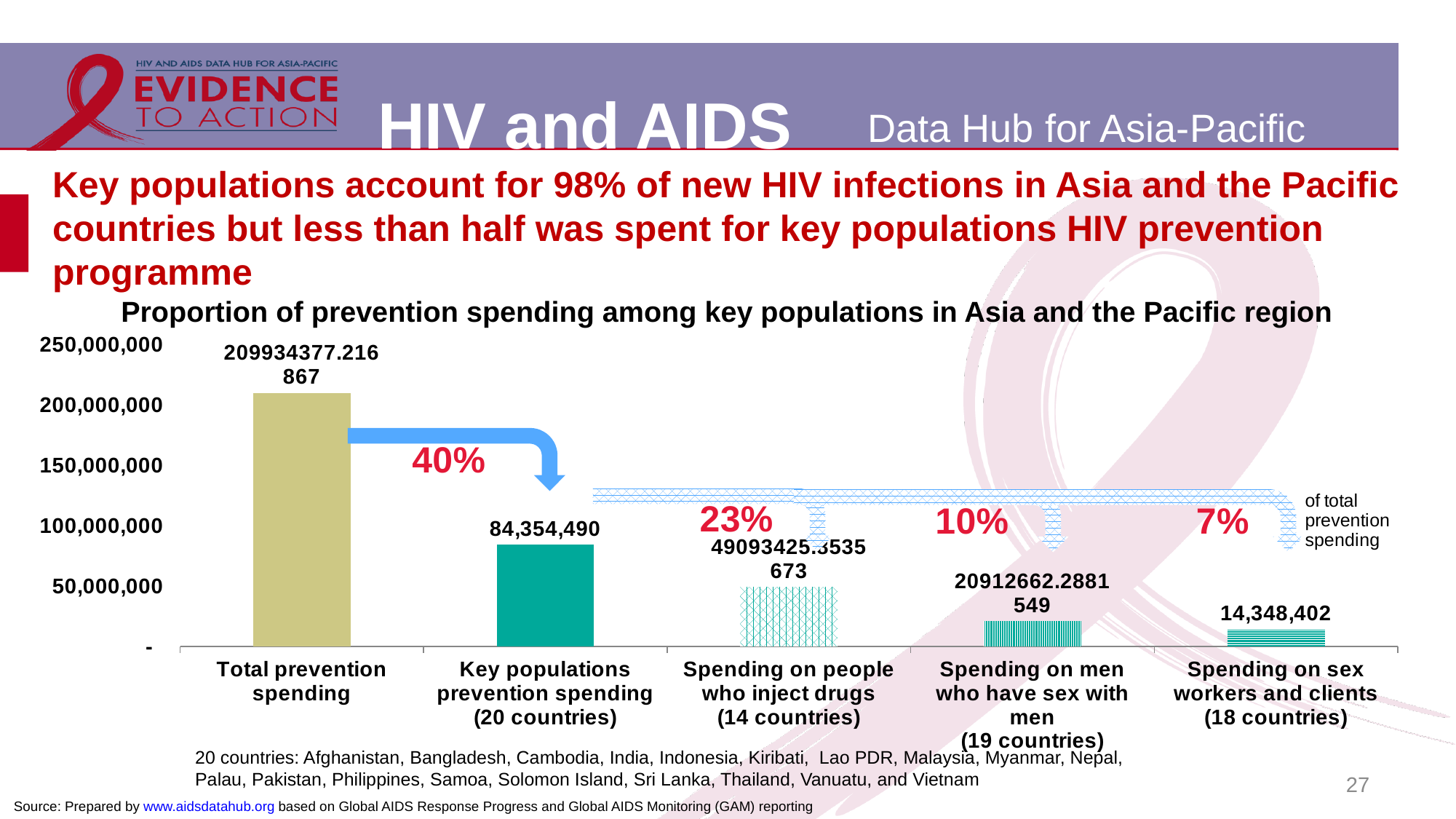
How many categories are plotted on the x axis of the chart? 5 Is the value for Total prevention spending greater or less than 200,000,000? greater What is the difference between Key populations prevention spending and Spending on sex workers and clients? 70,006,088 Which category has the highest value in the chart? Total prevention spending What is the value for Spending on men who have sex with men (19 countries)? 20912662.2881549 Which is larger: Spending on men who have sex with men or Spending on sex workers and clients? Spending on men who have sex with men What type of chart is shown on the slide? Bar chart What is the title of the chart? Proportion of prevention spending among key populations in Asia and the Pacific region Which category has the lowest value in the chart? Spending on sex workers and clients (18 countries) What is the value for Key populations prevention spending (20 countries)? 84,354,490 What is the value for Spending on sex workers and clients (18 countries)? 14,348,402 What percentage of total prevention spending is shown above the Spending on people who inject drugs bar? 23%